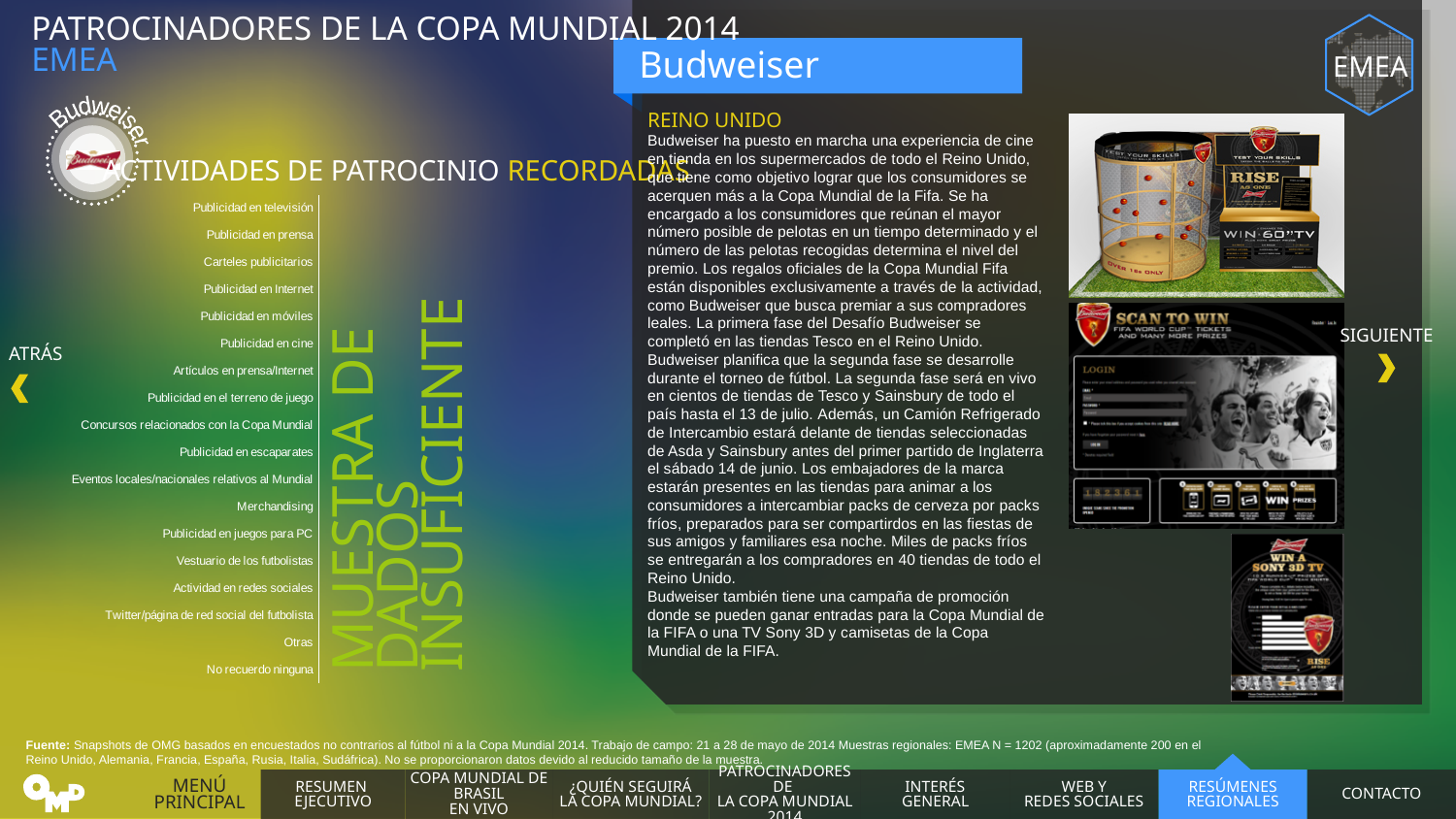
What is the title of the chart on the left side of the slide? Actividades de patrocinio recordadas What is the last category listed at the bottom of the 'Actividades de patrocinio recordadas' chart? No recuerdo ninguna What text is shown in place of the plotted data in the 'Actividades de patrocinio recordadas' chart? Muestra de dados insuficiente What is the first category listed at the top of the 'Actividades de patrocinio recordadas' chart? Publicidad en televisión How many categories are listed on the axis of the 'Actividades de patrocinio recordadas' chart? 18